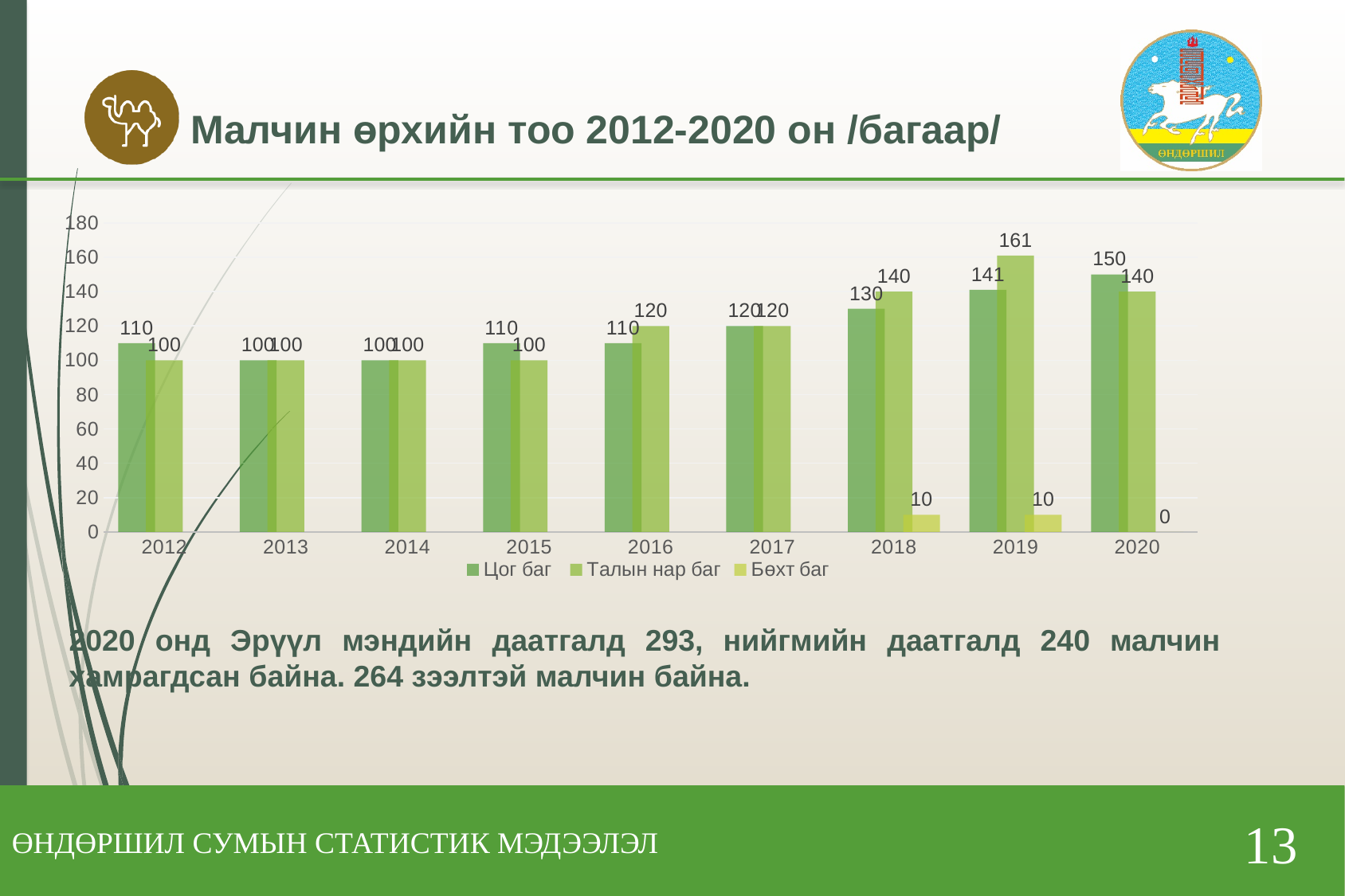
How many years are shown on the x axis? 9 In which year is the value for Талын нар баг highest? 2019 How many series does the legend list? 3 What is the value for Цог баг in 2020? 150 What is the value for Бөхт баг in 2018? 10 Which is larger in 2020, Цог баг or Талын нар баг? Цог баг In which year is the value for Цог баг lowest? 2013 and 2014 What is the title of the chart? Малчин өрхийн тоо 2012-2020 он /багаар/ Is the value for Цог баг in 2018 greater or less than 120? greater What is the value for Талын нар баг in 2019? 161 What kind of chart is shown on the slide? bar chart What is the difference between Талын нар баг and Цог баг in 2019? 20